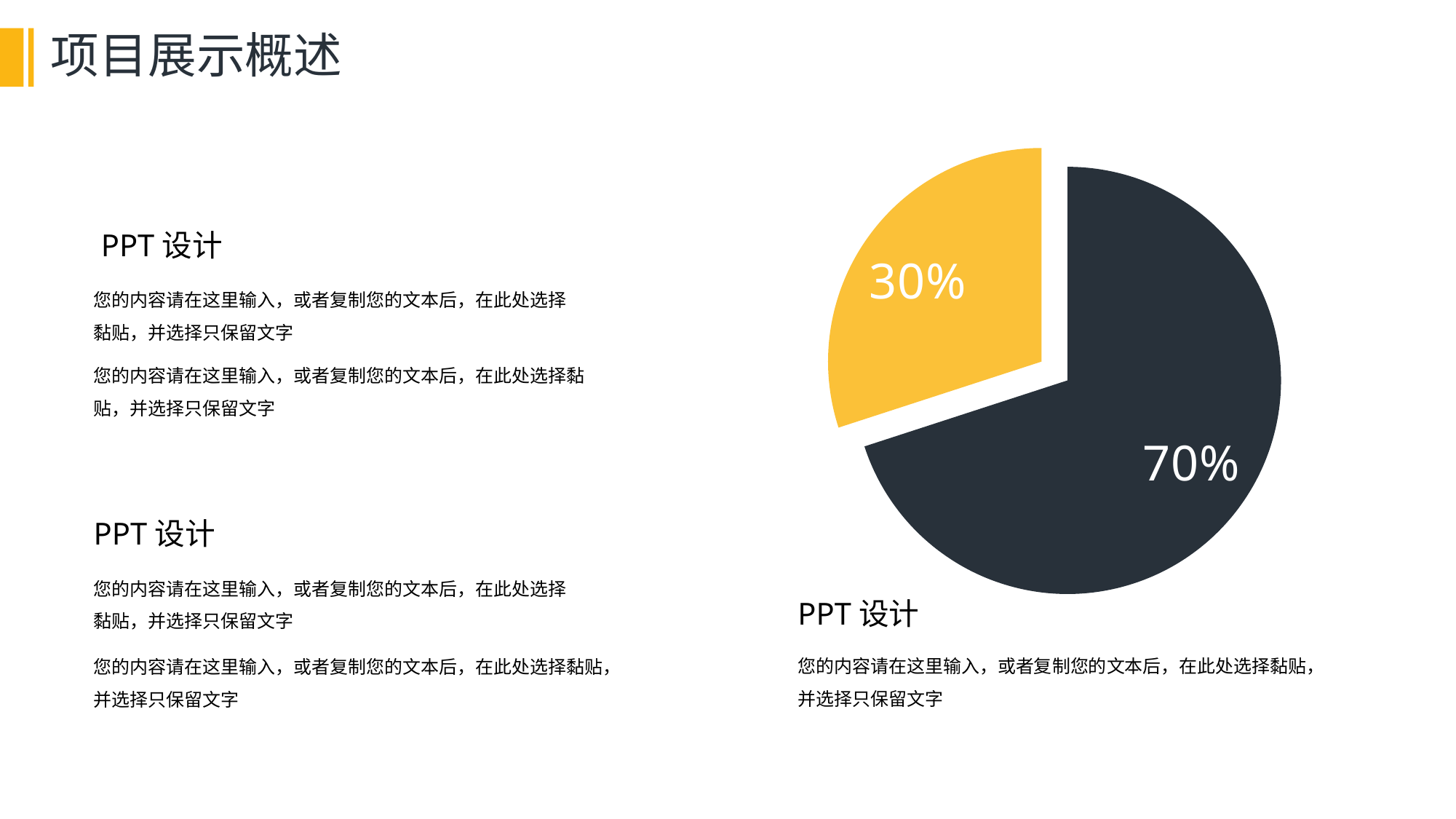
Which slice of the pie chart is the smallest? the yellow slice (30%) Which slice of the pie chart is the largest? the dark slice (70%) What value is labelled on the dark slice of the pie chart? 70% What is the difference between the dark slice and the yellow slice of the pie chart? 40% Is the yellow slice of the pie chart pulled out from the rest of the pie? yes What kind of chart is shown on the slide? pie chart What colour is the slice labelled 70%? dark grey Which is larger, the yellow slice or the dark slice? the dark slice What share of the pie does the yellow slice represent? 30% What do the two slices of the pie chart add up to? 100% How many slices does the pie chart have? 2 What value is labelled on the yellow slice of the pie chart? 30%